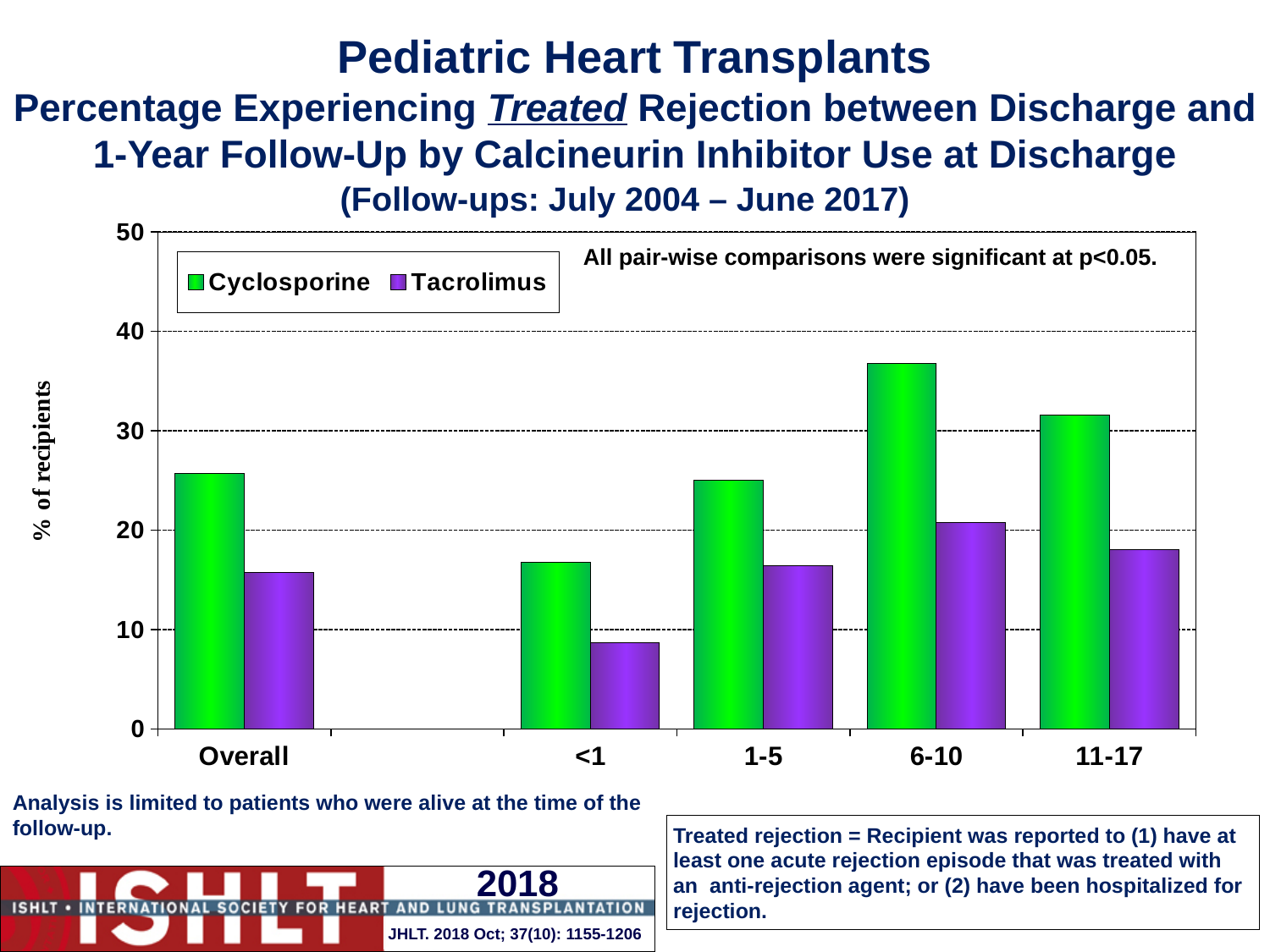
For which category is the Cyclosporine value highest? 6-10 For which category is the Tacrolimus value lowest? <1 In the 11-17 group, which series has the larger value, Cyclosporine or Tacrolimus? Cyclosporine How many series does the legend list? 2 How many age categories are shown on the x axis? 5 For which category is the Tacrolimus value highest? 6-10 Is the Tacrolimus value for the <1 group greater or less than 10? less Is the Cyclosporine value for the Overall group greater or less than 20? greater Which colour represents Tacrolimus in the legend? purple Is the Cyclosporine value for the 6-10 group greater or less than 30? greater What is the label on the y axis? % of recipients What kind of chart is shown on the slide? bar chart